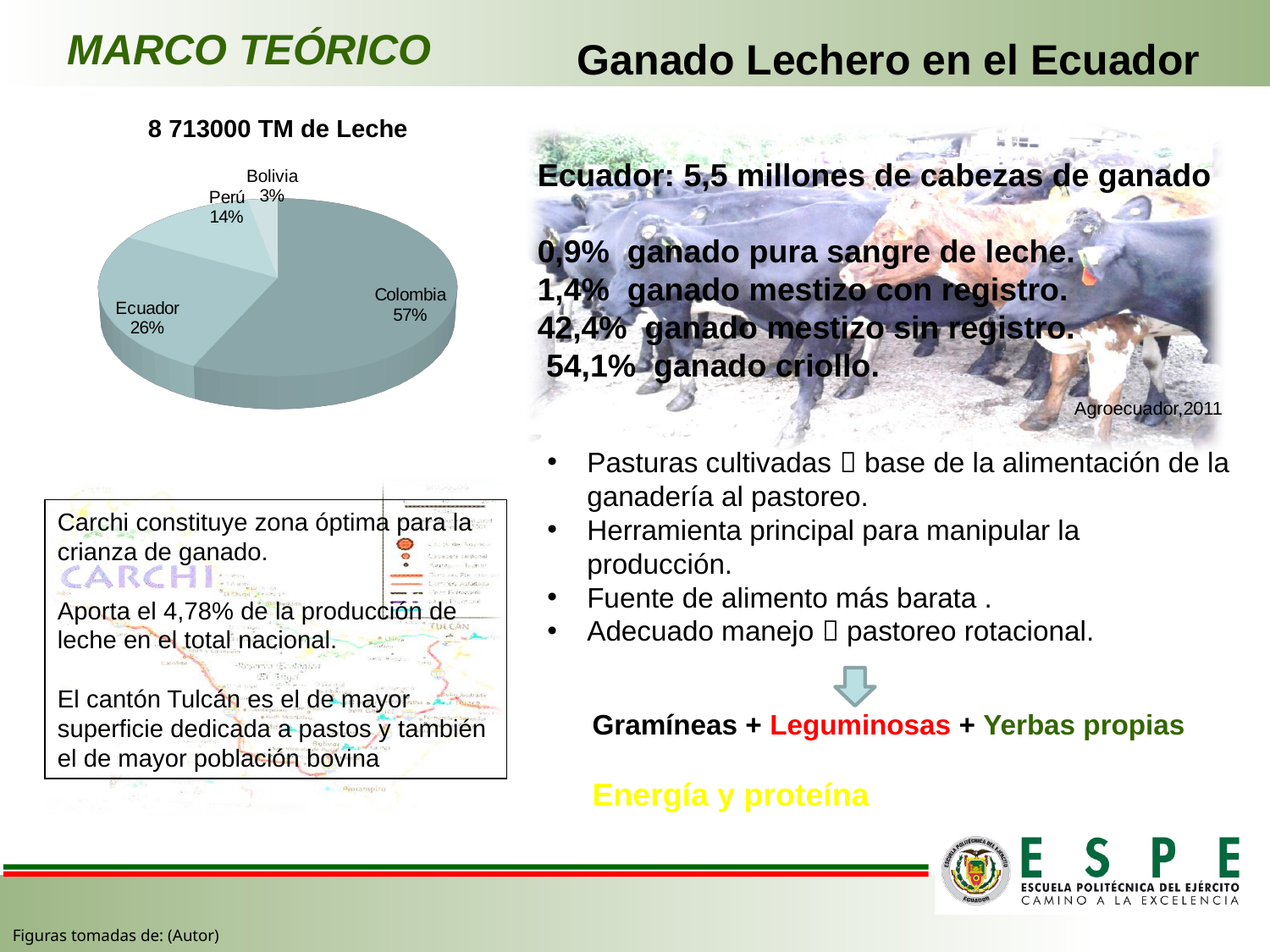
What share of the pie does Ecuador have? 26% What share of the pie does Bolivia have? 3% What share of the pie does Perú have? 14% What share of the pie does Colombia have? 57% Which country has the smallest slice of the pie? Bolivia What type of chart is shown on the slide? pie chart What is the title of the pie chart? 8 713000 TM de Leche How many countries are shown in the pie chart? 4 What is the difference in percentage points between Perú and Bolivia? 11 Which has a larger share, Ecuador or Perú? Ecuador What is the difference in percentage points between Colombia and Ecuador? 31 Which country has the largest slice of the pie? Colombia